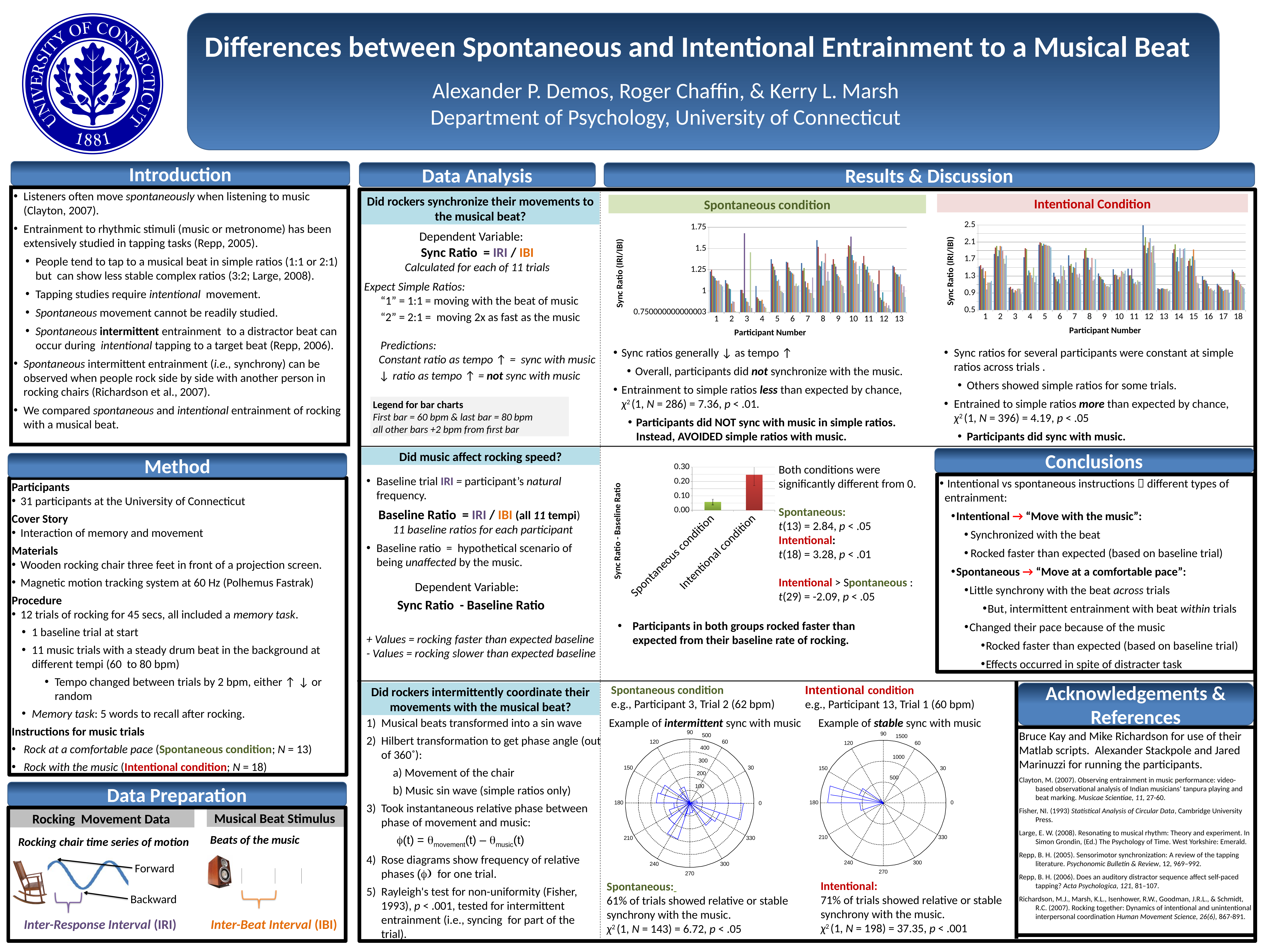
What is the highest y-axis tick value on the 'Intentional Condition' bar chart? 2.5 In the 'Sync Ratio - Baseline Ratio' bar chart, which condition has the higher value? Intentional condition In the 'Spontaneous condition' bar chart, is the tallest bar for participant 3 greater or less than 1.5? greater How many participants are shown on the x axis of the 'Intentional Condition' bar chart? 18 What is the y-axis label of the 'Intentional Condition' bar chart? Sync Ratio (IRI/IBI) What kind of chart is the 'Spontaneous condition' chart in the Results & Discussion section? bar chart In the 'Sync Ratio - Baseline Ratio' bar chart, is the value for the Spontaneous condition greater or less than 0.10? less How many participants are shown on the x axis of the 'Spontaneous condition' bar chart? 13 In the 'Sync Ratio - Baseline Ratio' bar chart, is the value for the Intentional condition greater or less than 0.20? greater How many categories are plotted in the 'Sync Ratio - Baseline Ratio' bar chart? 2 In the 'Sync Ratio - Baseline Ratio' bar chart, which condition has the lower value? Spontaneous condition